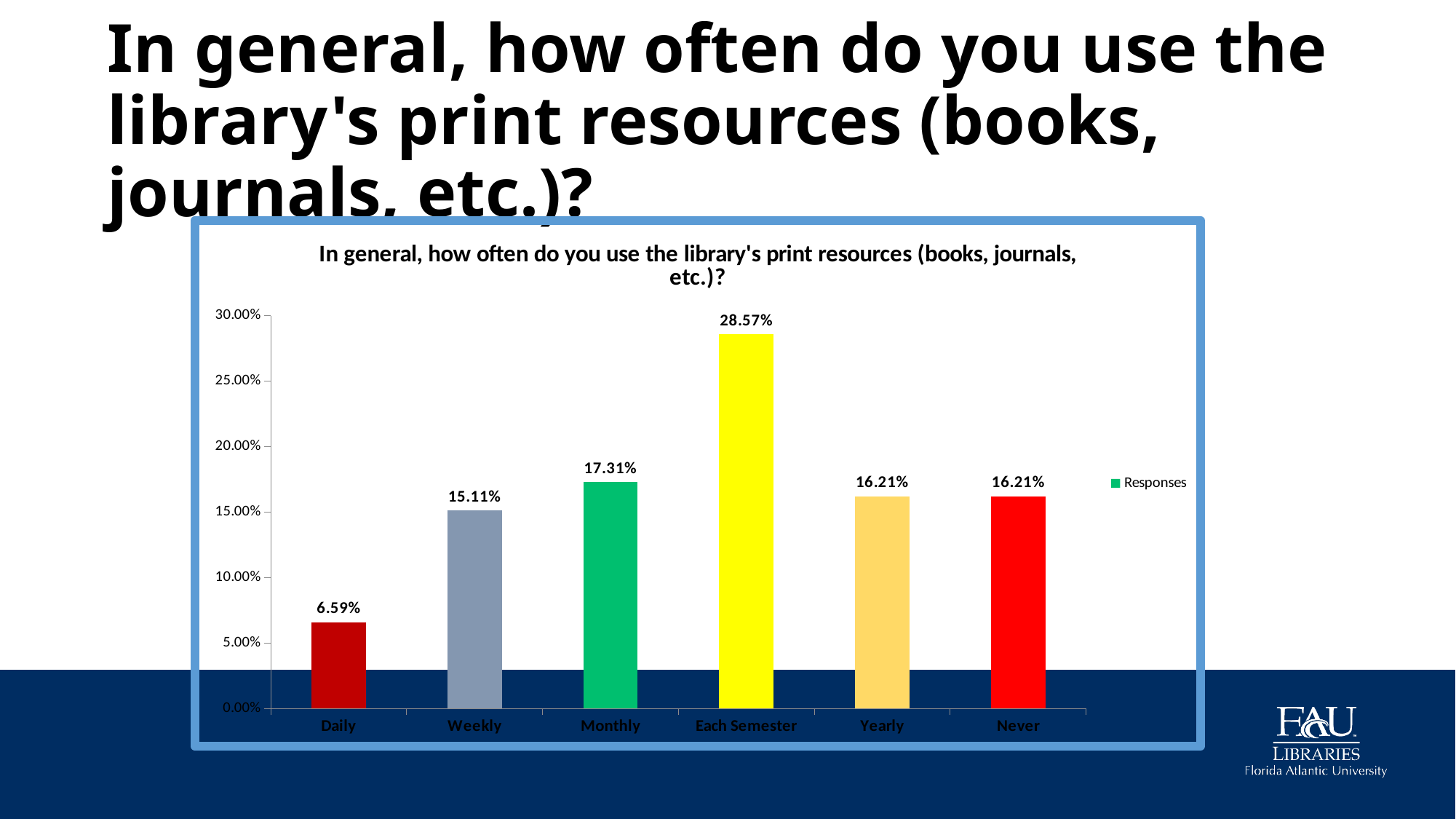
Which category has the highest percentage of responses? Each Semester Which is larger, the value for Monthly or the value for Weekly? Monthly Which category has the lowest percentage of responses? Daily What kind of chart is shown on the slide? bar chart How many categories are shown on the x axis? 6 What percentage of responses is shown for Daily? 6.59% How many series does the legend list? 1 What is the name of the series listed in the legend? Responses What percentage of responses is shown for Each Semester? 28.57% What is the difference between the Each Semester and Weekly percentages? 13.46% What percentage of responses is shown for Monthly? 17.31% Is the value for Weekly greater or less than 20.00%? less